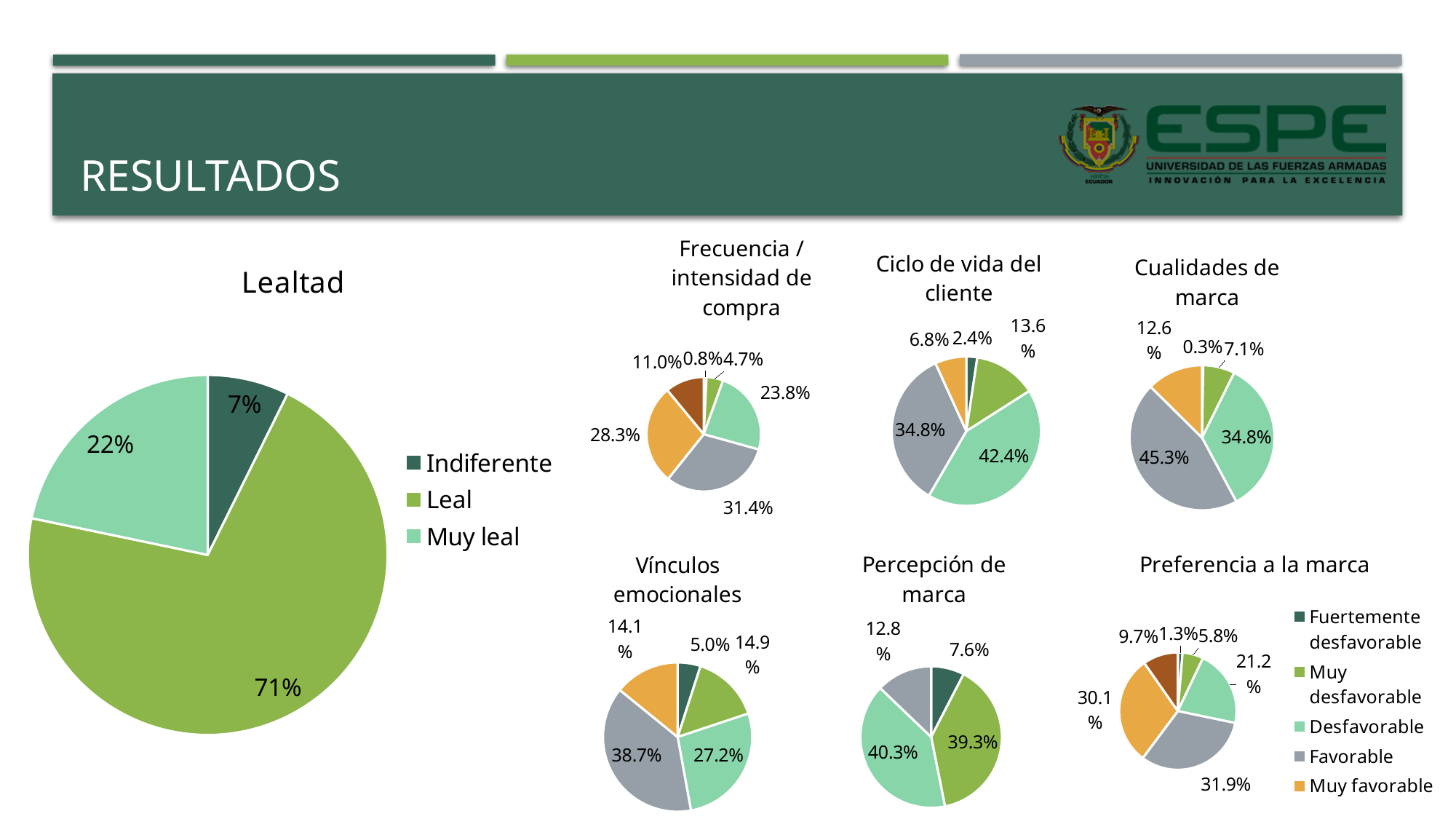
In the Ciclo de vida del cliente chart, what is the value of the largest slice? 42.4% In the Vínculos emocionales chart, what is the difference between the 38.7% slice and the 27.2% slice? 11.5% How many entries does the legend next to the Preferencia a la marca chart list? 5 In the Lealtad chart, which category has the smallest share? Indiferente In the Preferencia a la marca chart, what percentage is shown for Favorable? 31.9% In the Lealtad chart, which category has the largest share? Leal In the Lealtad chart, what is the difference between the Muy leal and Indiferente shares? 15% In the Percepción de marca chart, what is the value of the smallest slice? 7.6% In the Lealtad chart, what percentage is shown for Leal? 71% In the Cualidades de marca chart, what is the value of the largest slice? 45.3% What type of chart is the Lealtad chart? Pie chart How many entries does the legend of the Lealtad chart list? 3